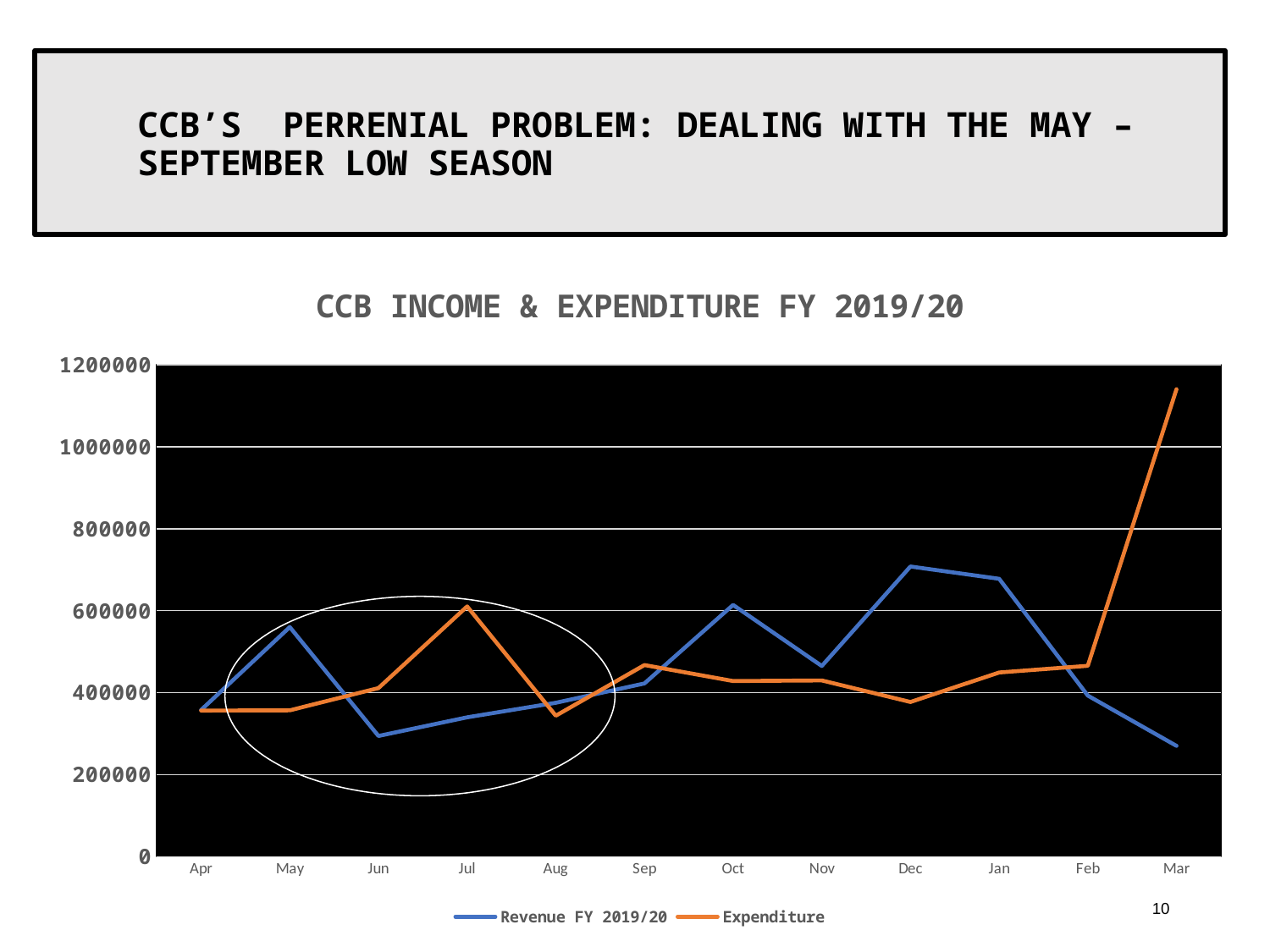
How many series does the legend list? 2 In which month is Revenue FY 2019/20 highest? Dec In Dec, which is larger: Revenue FY 2019/20 or Expenditure? Revenue FY 2019/20 Is the Revenue FY 2019/20 value for Jun greater or less than 400000? less What is the title of the chart? CCB INCOME & EXPENDITURE FY 2019/20 Is the Revenue FY 2019/20 value for Dec greater or less than 600000? greater Does Revenue FY 2019/20 rise or fall from Dec to Mar? Fall How many months are shown along the x axis? 12 What kind of chart is shown on the slide? Line chart In which month is Expenditure highest? Mar In Jul, which is larger: Revenue FY 2019/20 or Expenditure? Expenditure Is the Expenditure value for Mar greater or less than 1000000? greater